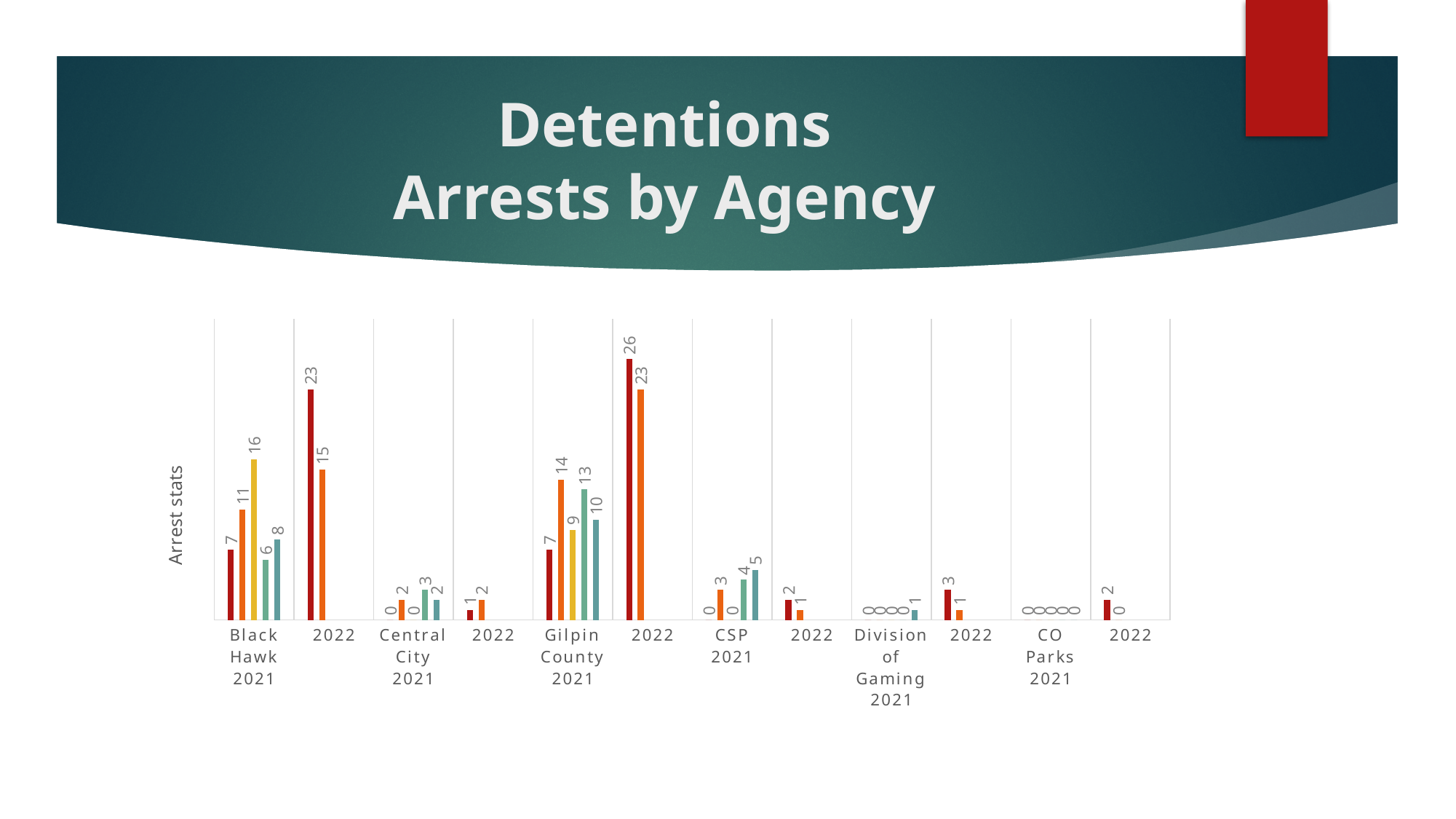
What is the value of the tallest (yellow) bar for Black Hawk 2021? 16 What is the difference between the dark red bar (23) and the orange bar (15) for Black Hawk 2022? 8 What kind of chart is shown on the slide? bar chart What is the value of the teal bar for CSP 2021? 5 What is the value of the dark red bar for Division of Gaming 2022? 3 What is the value of the orange bar for Black Hawk 2022? 15 Which is larger: the dark red bar for Gilpin County 2022 or the dark red bar for Black Hawk 2022? Gilpin County 2022 Which category contains the highest single bar value in the chart? Gilpin County 2022 How many categories are shown along the x axis of the chart? 12 What is the title shown above the chart on the slide? Detentions Arrests by Agency What is the value of the dark red bar for Gilpin County 2022? 26 What is the label on the vertical axis of the chart? Arrest stats